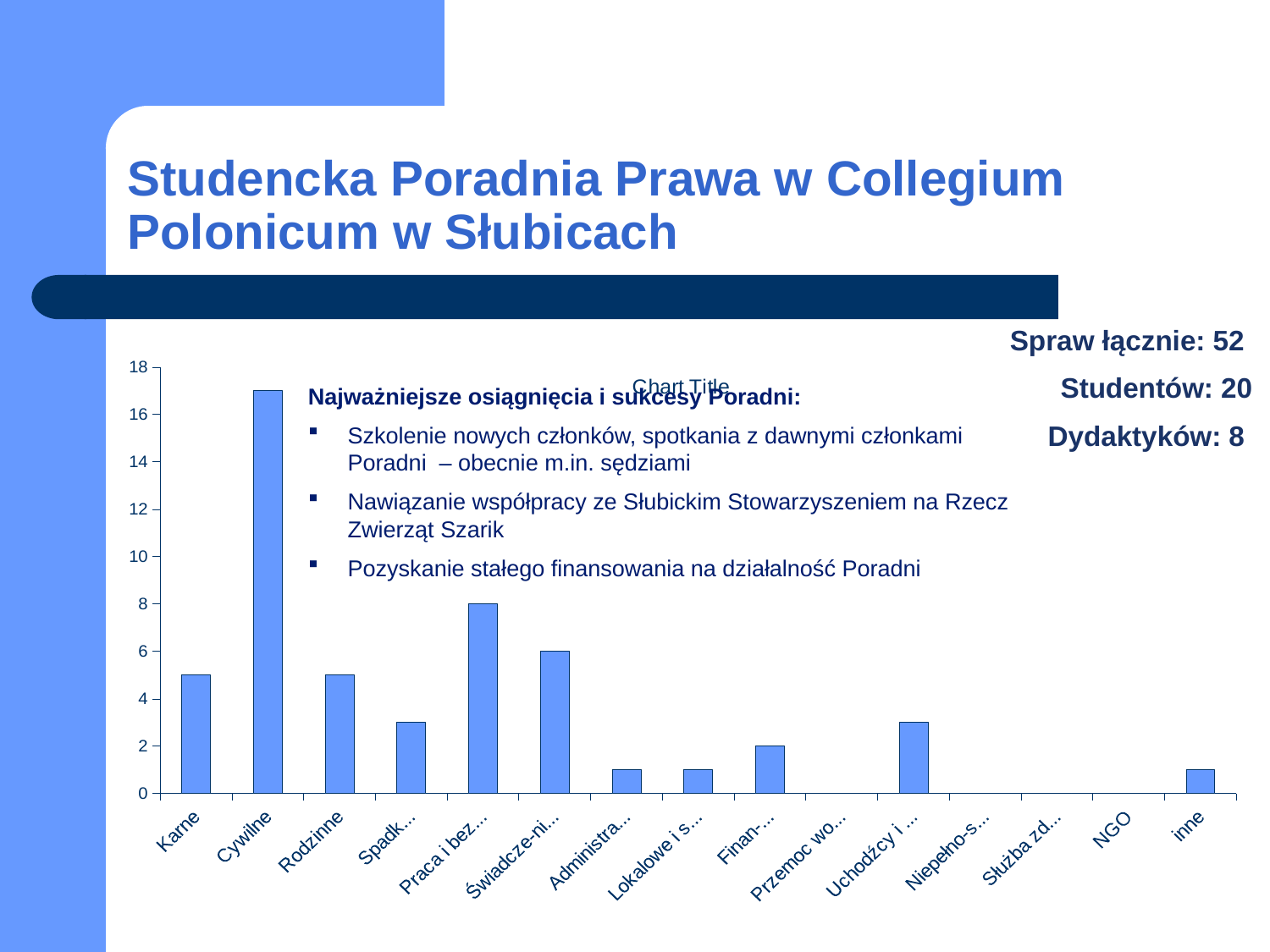
What title is printed above the chart? Chart Title What kind of chart is shown on the slide? bar chart What is the value for "Finan-..." in the chart? 2 What is the value for "Praca i bez..." in the chart? 8 What is the value for "Świadcze-ni..." in the chart? 6 Is the value for Cywilne greater or less than 16? greater Is the value for Karne greater or less than 4? greater Which is larger, the value for "Praca i bez..." or the value for "Świadcze-ni..."? Praca i bez... Which category has the highest bar in the chart? Cywilne Is the value for "Administra..." greater or less than 2? less What is the difference between the values for "Praca i bez..." and "Finan-..."? 6 How many categories are shown on the x axis of the chart? 15